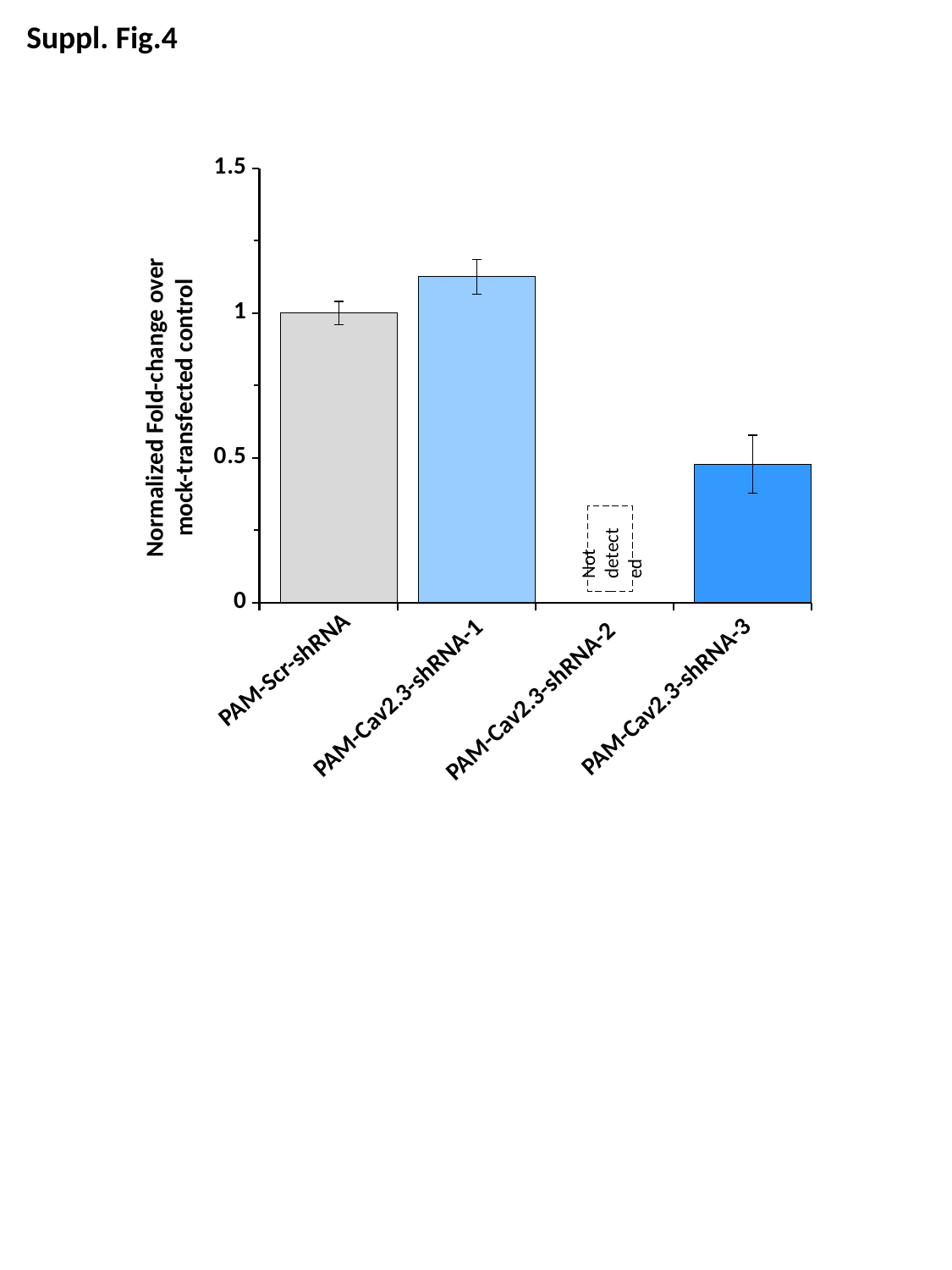
Which of the plotted bars is the lowest? PAM-Cav2.3-shRNA-3 Which is larger, the value for PAM-Cav2.3-shRNA-1 or the value for PAM-Scr-shRNA? PAM-Cav2.3-shRNA-1 What is shown in place of a bar for PAM-Cav2.3-shRNA-2? Not detected What is the normalized fold-change value for PAM-Scr-shRNA? 1 How many categories are shown on the x axis of the chart? 4 Which is larger, the value for PAM-Scr-shRNA or the value for PAM-Cav2.3-shRNA-3? PAM-Scr-shRNA Is the value for PAM-Cav2.3-shRNA-1 greater or less than 1? greater What is the label of the y axis of the chart? Normalized Fold-change over mock-transfected control What kind of chart is shown on the slide? bar chart Is the value for PAM-Cav2.3-shRNA-3 greater or less than 1? less Which category has the highest bar in the chart? PAM-Cav2.3-shRNA-1